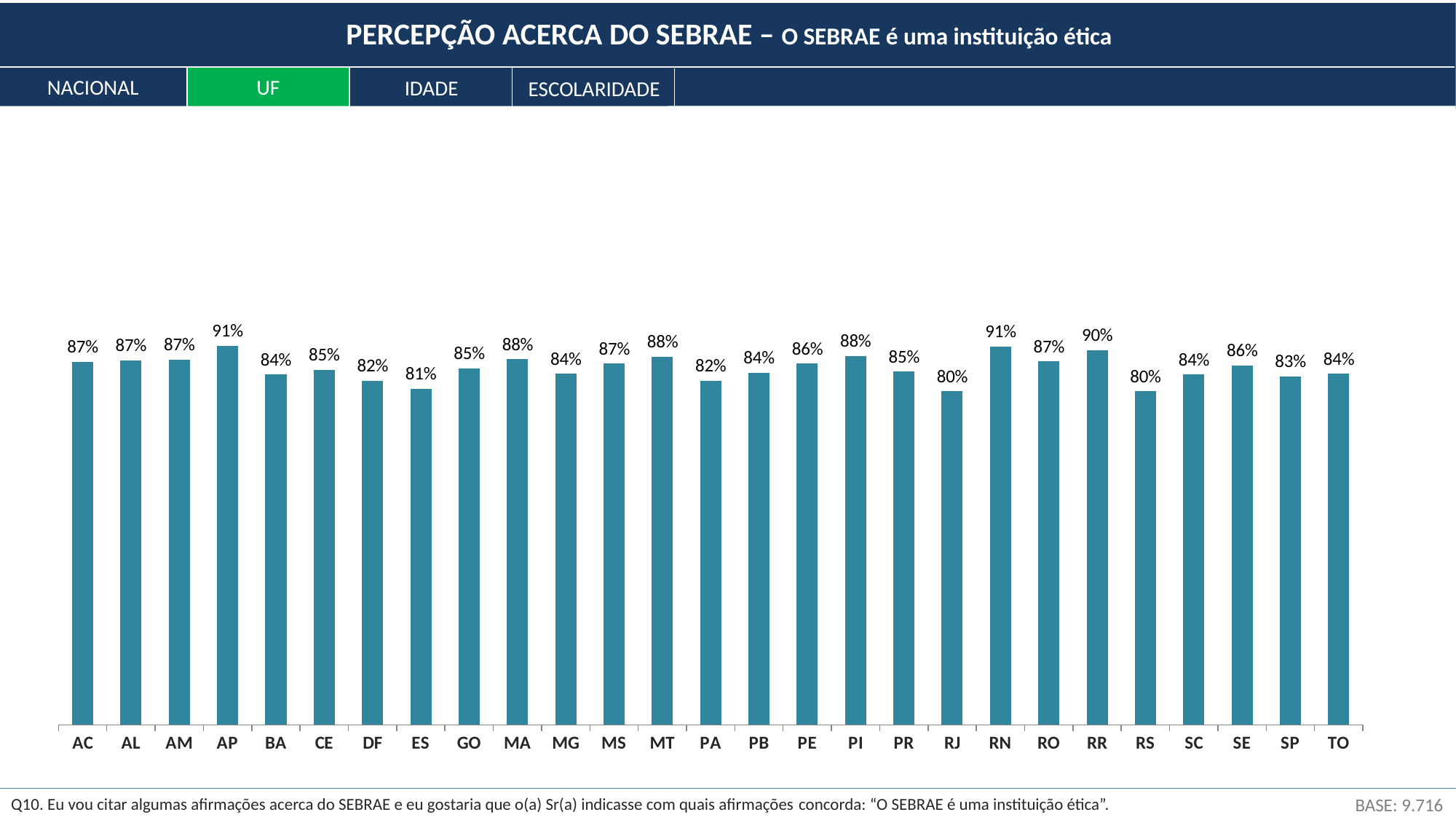
What is the value for RJ? 80% What is the difference between the values for RN and RS? 11% What is the difference between the values for RR and ES? 9% What kind of chart is shown on the slide? Bar chart Which two states share the lowest value on the chart? RJ and RS Which is larger, the value for MA or the value for DF? MA What is the value for PE? 86% How many states (categories) are shown on the chart? 27 What is the value for AP? 91% Which tab is highlighted in green at the top of the slide? UF What is the value for SP? 83% Which two states share the highest value on the chart? AP and RN